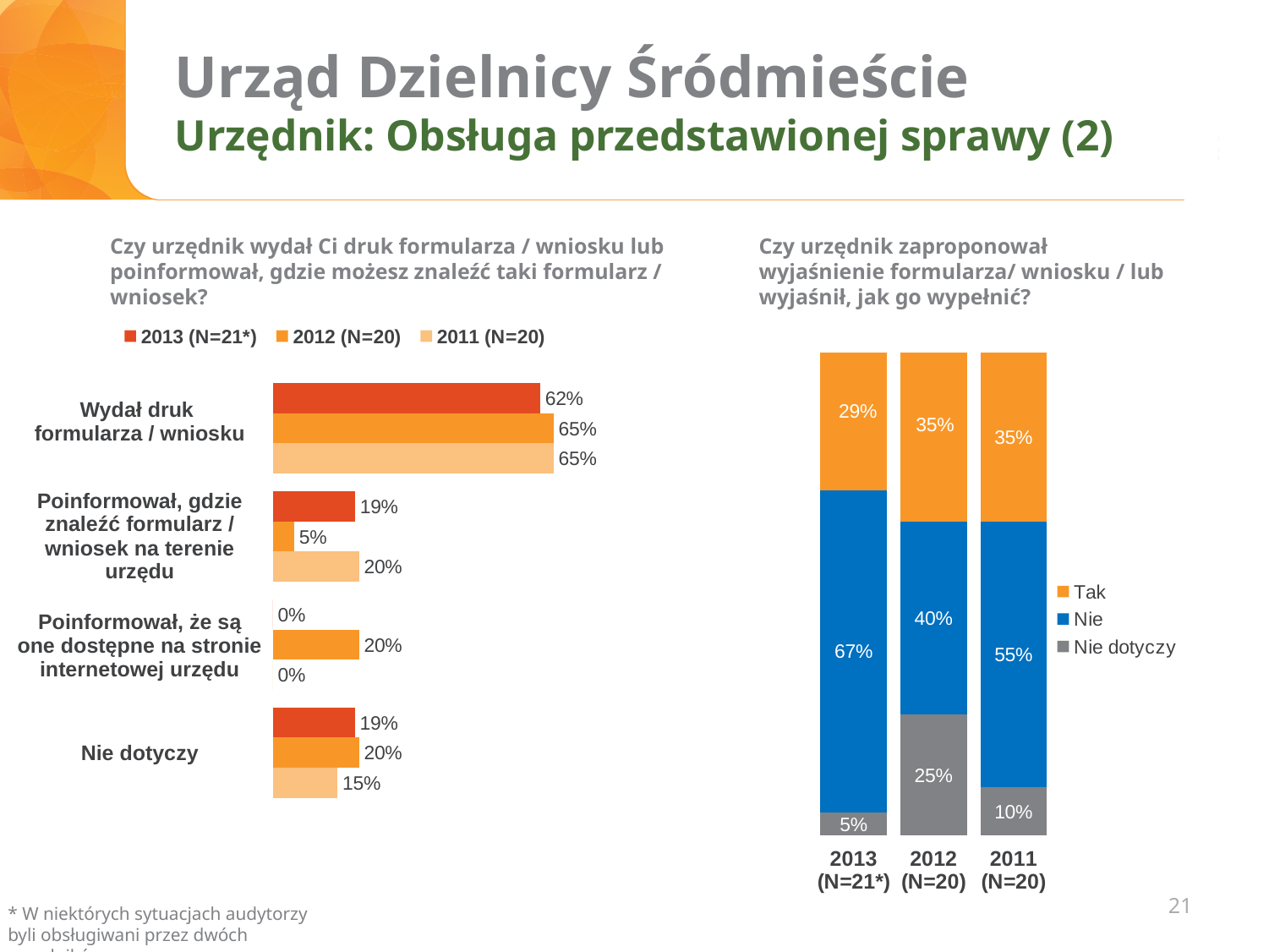
What type of chart is the right chart? Stacked bar chart In the left chart, what is the 2013 (N=21*) value for "Wydał druk formularza / wniosku"? 62% In the left chart, what is the difference between the 2011 (N=20) and 2012 (N=20) values for "Poinformował, gdzie znaleźć formularz / wniosek na terenie urzędu"? 15% In the right chart, what is the "Nie" value for 2012 (N=20)? 40% In the right chart, is the "Nie" value larger for 2012 (N=20) or 2011 (N=20)? 2011 (N=20) In the left chart, which category has the highest 2013 (N=21*) value? Wydał druk formularza / wniosku In the right chart, which year has the highest "Nie" value? 2013 (N=21*) In the right chart, what is the "Nie dotyczy" value for 2013 (N=21*)? 5% In the left chart, how many series does the legend list? 3 In the left chart, what is the 2012 (N=20) value for "Poinformował, gdzie znaleźć formularz / wniosek na terenie urzędu"? 5% In the left chart, how many categories are shown? 4 In the left chart, what is the 2011 (N=20) value for "Nie dotyczy"? 15%